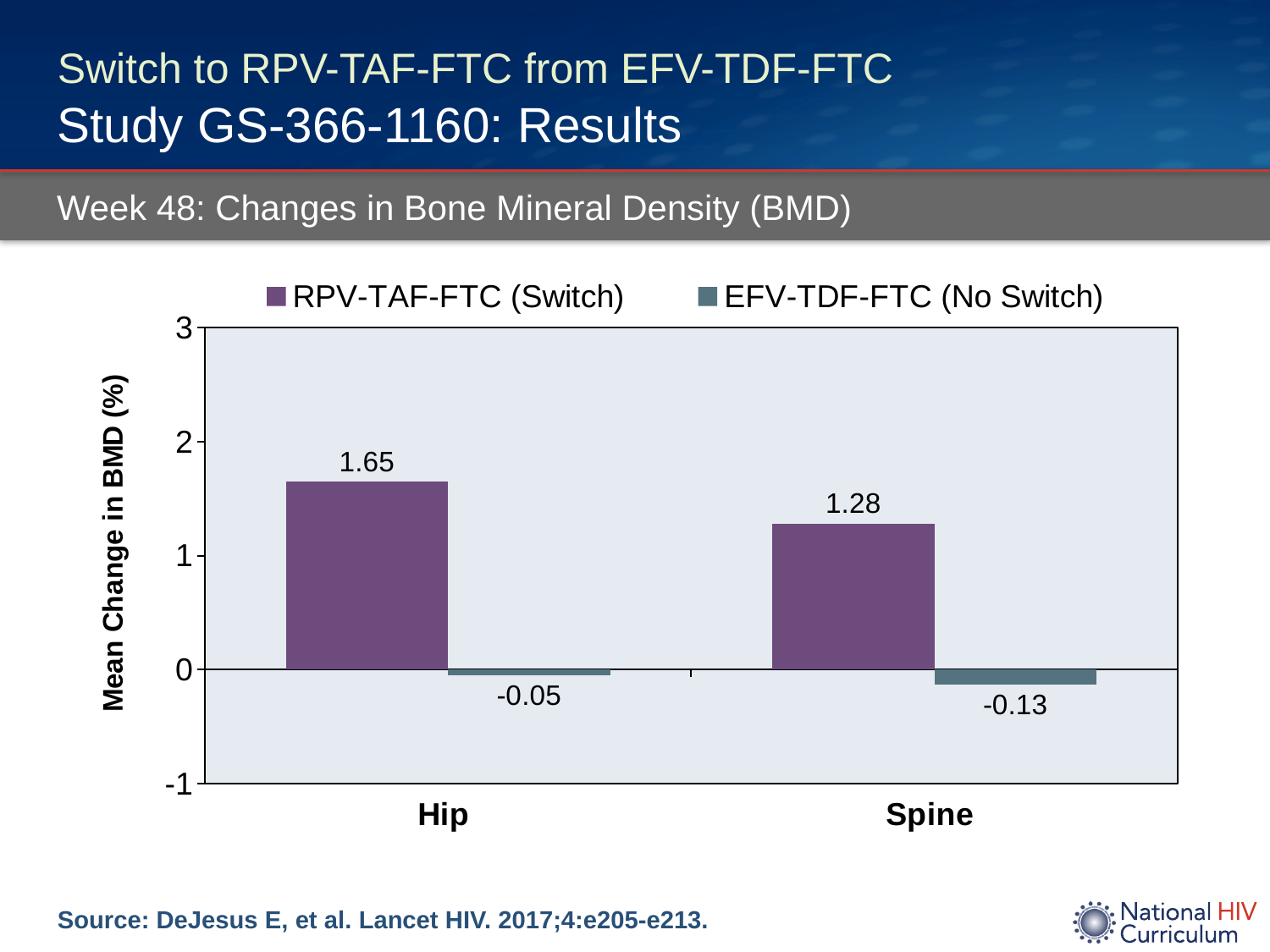
What kind of chart is shown on the slide? Bar chart What is the mean change in BMD for RPV-TAF-FTC (Switch) at the Hip? 1.65 What is the difference between the RPV-TAF-FTC (Switch) values at the Hip and the Spine? 0.37 Which bar shows the highest mean change in BMD? RPV-TAF-FTC (Switch) at the Hip Is the RPV-TAF-FTC (Switch) value at the Spine greater or less than 1? greater What is the mean change in BMD for EFV-TDF-FTC (No Switch) at the Spine? -0.13 What is the difference between the RPV-TAF-FTC (Switch) and EFV-TDF-FTC (No Switch) values at the Spine? 1.41 What is the mean change in BMD for EFV-TDF-FTC (No Switch) at the Hip? -0.05 What is the mean change in BMD for RPV-TAF-FTC (Switch) at the Spine? 1.28 How many series does the legend list? 2 Which bar shows the lowest mean change in BMD? EFV-TDF-FTC (No Switch) at the Spine Which is larger: the RPV-TAF-FTC (Switch) value at the Hip or at the Spine? Hip